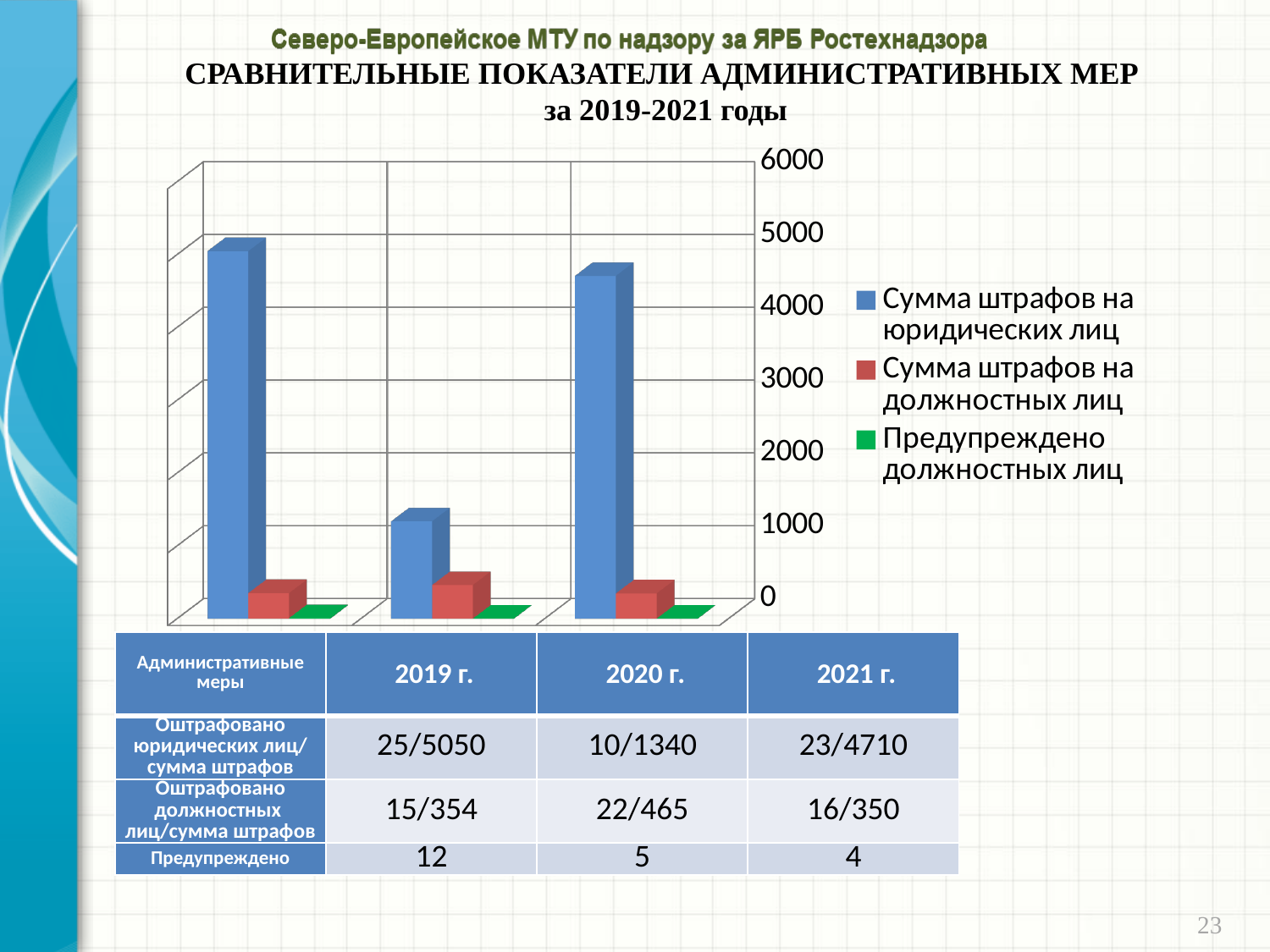
Is the value of the "Сумма штрафов на юридических лиц" bar in the second group (2020) greater or less than 2000? less What is the highest value shown on the chart's vertical axis? 6000 How many series does the chart legend list? 3 What kind of chart is shown on the slide? bar chart According to the table below the chart, what is the sum of fines on legal entities (сумма штрафов на юридических лиц) for 2021? 4710 How many groups of bars are plotted in the chart? 3 In which group of bars is "Сумма штрафов на юридических лиц" the lowest? the second group (2020) Which colour represents "Предупреждено должностных лиц" in the chart legend? green In which group of bars is "Сумма штрафов на юридических лиц" the highest? the first group (2019) Is the value of the "Сумма штрафов на юридических лиц" bar in the first group (2019) greater or less than 4000? greater Which is larger: the "Сумма штрафов на юридических лиц" bar in the first group (2019) or in the third group (2021)? the first group (2019) Is the value of the "Сумма штрафов на должностных лиц" bar in the third group (2021) greater or less than 1000? less